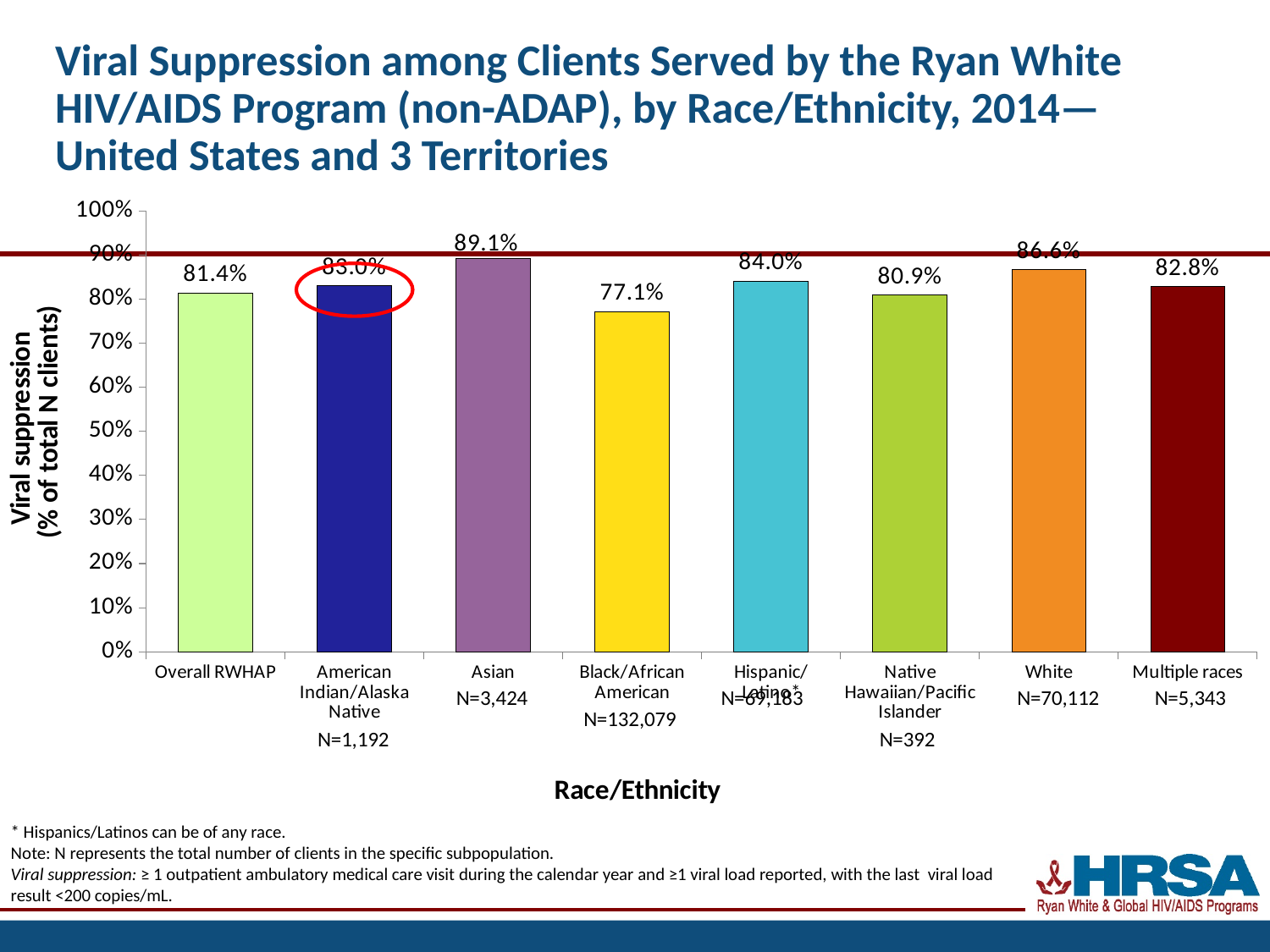
Which has a higher viral suppression percentage: Hispanic/Latino or Native Hawaiian/Pacific Islander? Hispanic/Latino What is the viral suppression percentage for Overall RWHAP? 81.4% What is the difference in viral suppression between Asian and Black/African American clients? 12.0 percentage points What is the x-axis title of the chart? Race/Ethnicity Is the viral suppression value for White clients greater or less than 80%? greater What is the viral suppression percentage for Black/African American clients? 77.1% What is the viral suppression percentage for Asian clients? 89.1% Which race/ethnicity category has the highest viral suppression percentage? Asian How many race/ethnicity categories are shown on the chart? 8 What type of chart is shown on the slide? Bar chart Which race/ethnicity category has the lowest viral suppression percentage? Black/African American What is the viral suppression percentage for clients of Multiple races? 82.8%